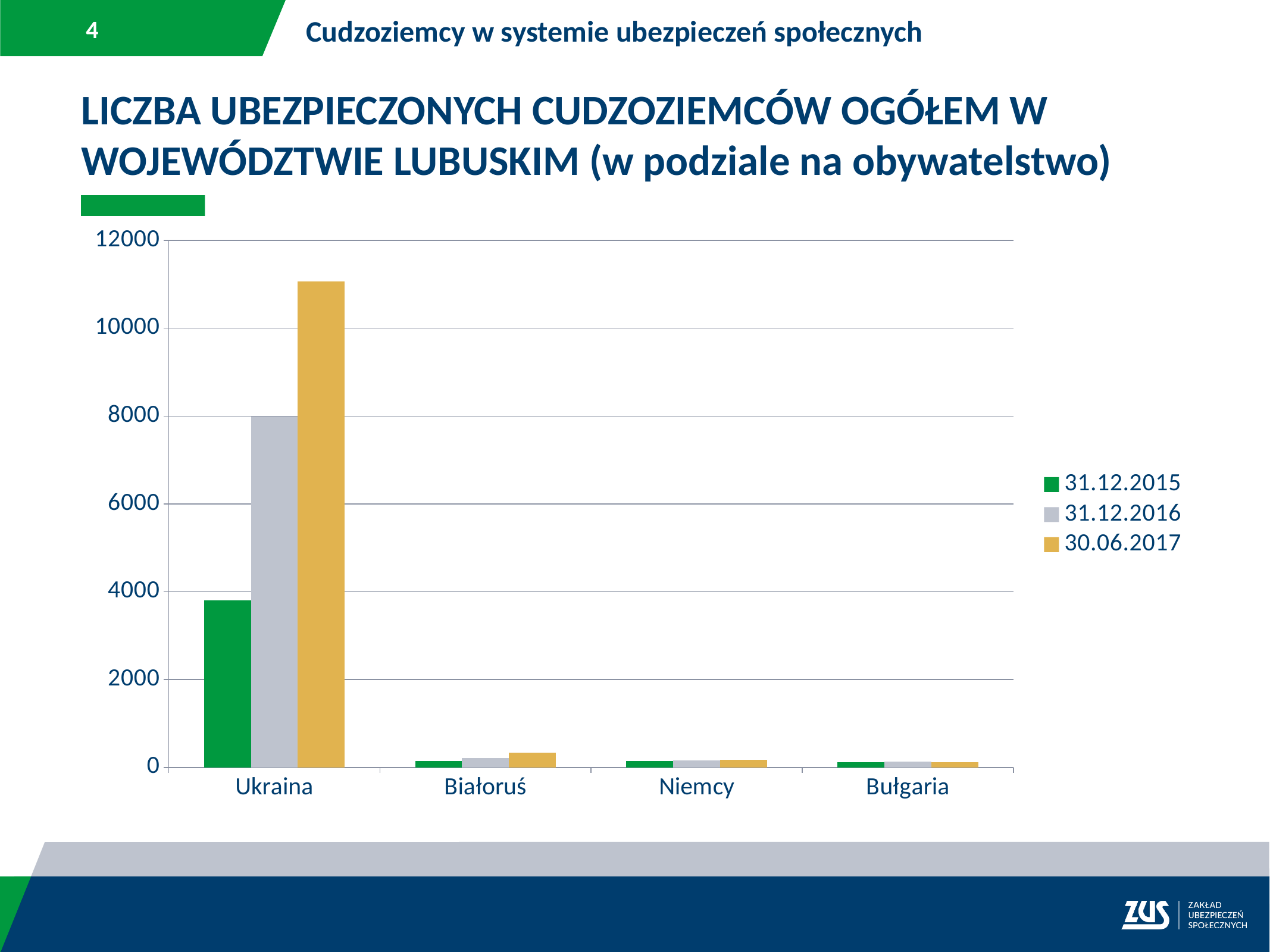
Is the value for Ukraina on 30.06.2017 greater or less than 10000? greater What kind of chart is shown on the slide? bar chart Is the value for Ukraina on 31.12.2015 greater or less than 4000? less Which colour represents the 30.06.2017 series in the chart? gold (yellow) How many series does the chart's legend list? 3 How many countries (categories) are shown on the x axis of the chart? 4 For Ukraina, do the values rise or fall from 31.12.2015 through 30.06.2017? rise What are the three dates listed in the chart's legend? 31.12.2015, 31.12.2016, 30.06.2017 Which country has the highest number of insured foreigners in the chart? Ukraina Is the value for Białoruś on 30.06.2017 greater or less than 2000? less For Ukraina, which is larger: the value for 31.12.2016 or the value for 30.06.2017? 30.06.2017